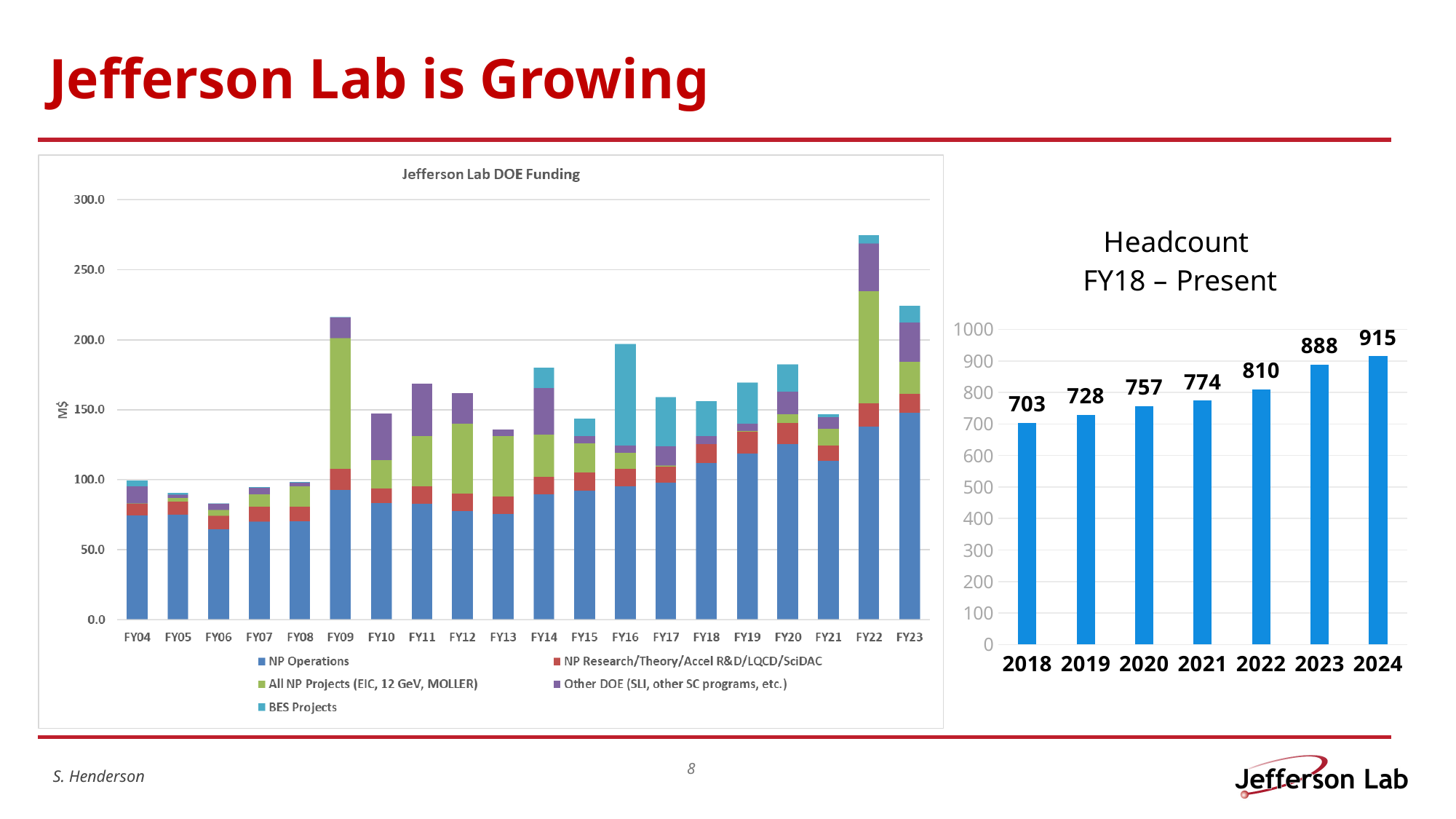
In the Jefferson Lab DOE Funding chart, is the total funding for FY22 greater or less than 250.0? greater In the Jefferson Lab DOE Funding chart, how many fiscal years are shown on the x axis? 20 In the Headcount FY18 – Present chart, what is the difference between the 2024 and 2018 headcounts? 212 In the Jefferson Lab DOE Funding chart, which fiscal year has the highest total funding? FY22 In the Headcount FY18 – Present chart, which year has the highest headcount? 2024 In the Headcount FY18 – Present chart, do the values rise or fall from 2018 to 2024? rise In the Headcount FY18 – Present chart, which is larger, the headcount for 2021 or for 2022? 2022 In the Headcount FY18 – Present chart, what is the headcount for 2023? 888 In the Headcount FY18 – Present chart, which year has the lowest headcount? 2018 In the Headcount FY18 – Present chart, what is the headcount for 2020? 757 In the Headcount FY18 – Present chart, how many years are shown? 7 In the Jefferson Lab DOE Funding chart, how many series does the legend list? 5